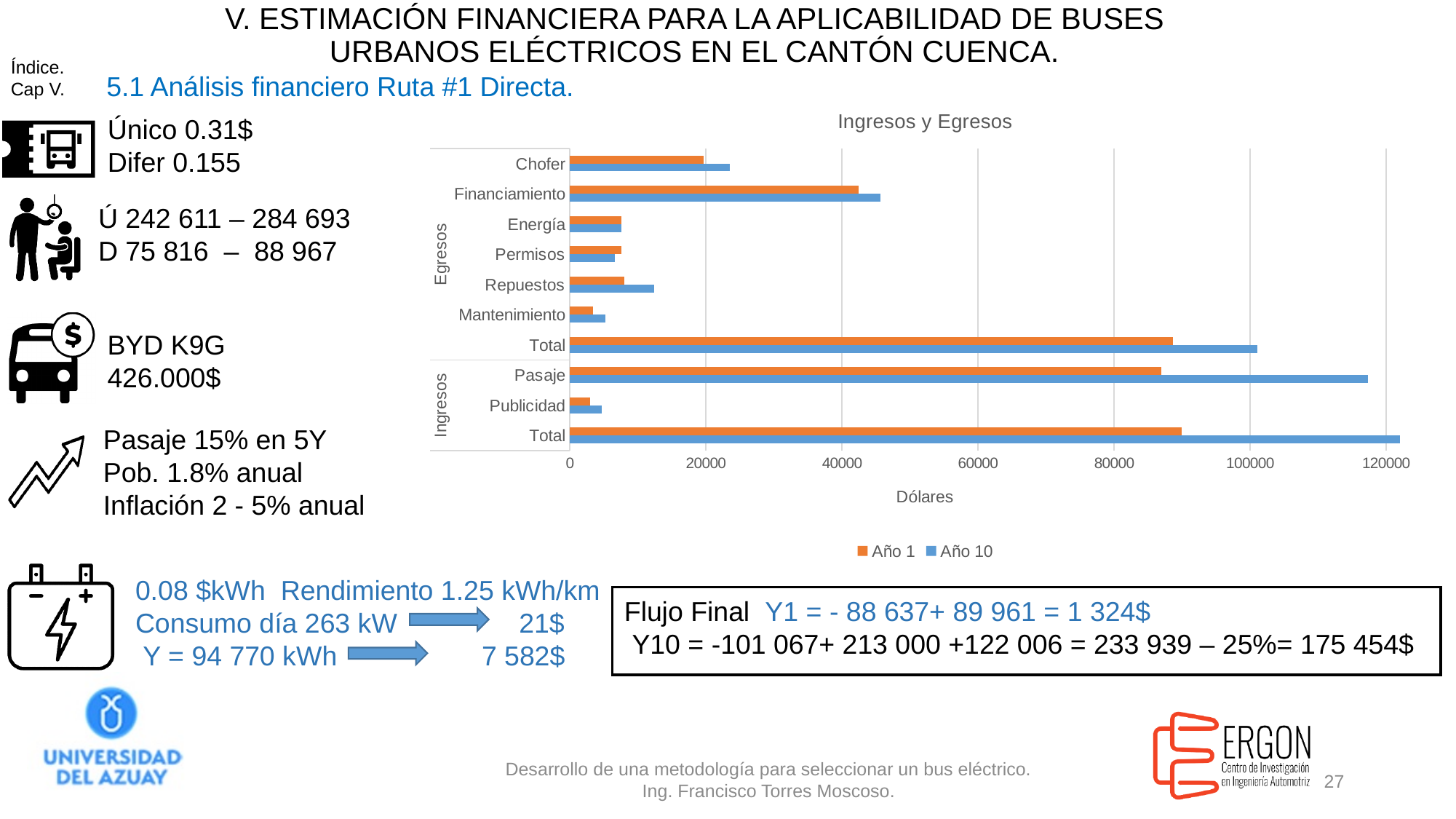
Which category has the longest bar in the 'Ingresos y Egresos' chart? Total (Ingresos), Año 10 For Año 10, which is larger: Pasaje or Chofer? Pasaje Is the Año 10 value for Chofer greater or less than 20000? greater Is the Año 10 value for Pasaje greater or less than 100000? greater How many series does the legend of the 'Ingresos y Egresos' chart list? 2 What is the label of the horizontal axis of the 'Ingresos y Egresos' chart? Dólares What are the two series named in the legend of the 'Ingresos y Egresos' chart? Año 1 and Año 10 What kind of chart is shown on the slide? bar chart Is the Año 1 value for Financiamiento greater or less than 40000? greater For Año 1, which is larger: Financiamiento or Energía? Financiamiento How many categories are plotted on the vertical axis of the 'Ingresos y Egresos' chart? 10